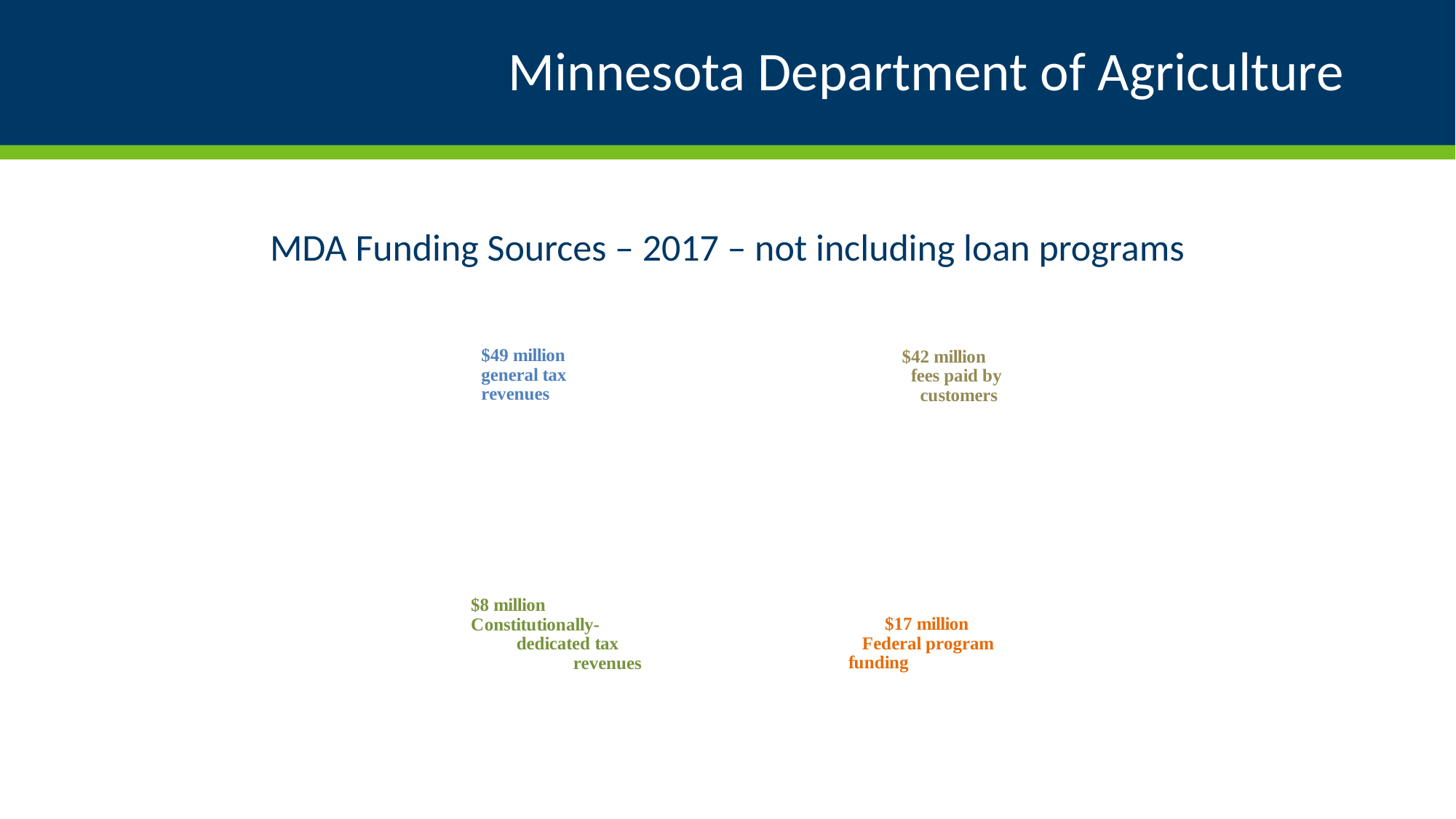
What is the value for Federal program funding? $17 million What is the difference between general tax revenues and fees paid by customers? $7 million Which is larger, Federal program funding or fees paid by customers? fees paid by customers What is the value for general tax revenues? $49 million What year do the funding sources on the chart refer to? 2017 What is the title of the chart? MDA Funding Sources – 2017 – not including loan programs Which funding source has the highest value? general tax revenues Which funding source has the lowest value? Constitutionally-dedicated tax revenues What is the difference between Federal program funding and Constitutionally-dedicated tax revenues? $9 million What is the value for fees paid by customers? $42 million What is the value for Constitutionally-dedicated tax revenues? $8 million How many funding sources are labelled on the chart? 4